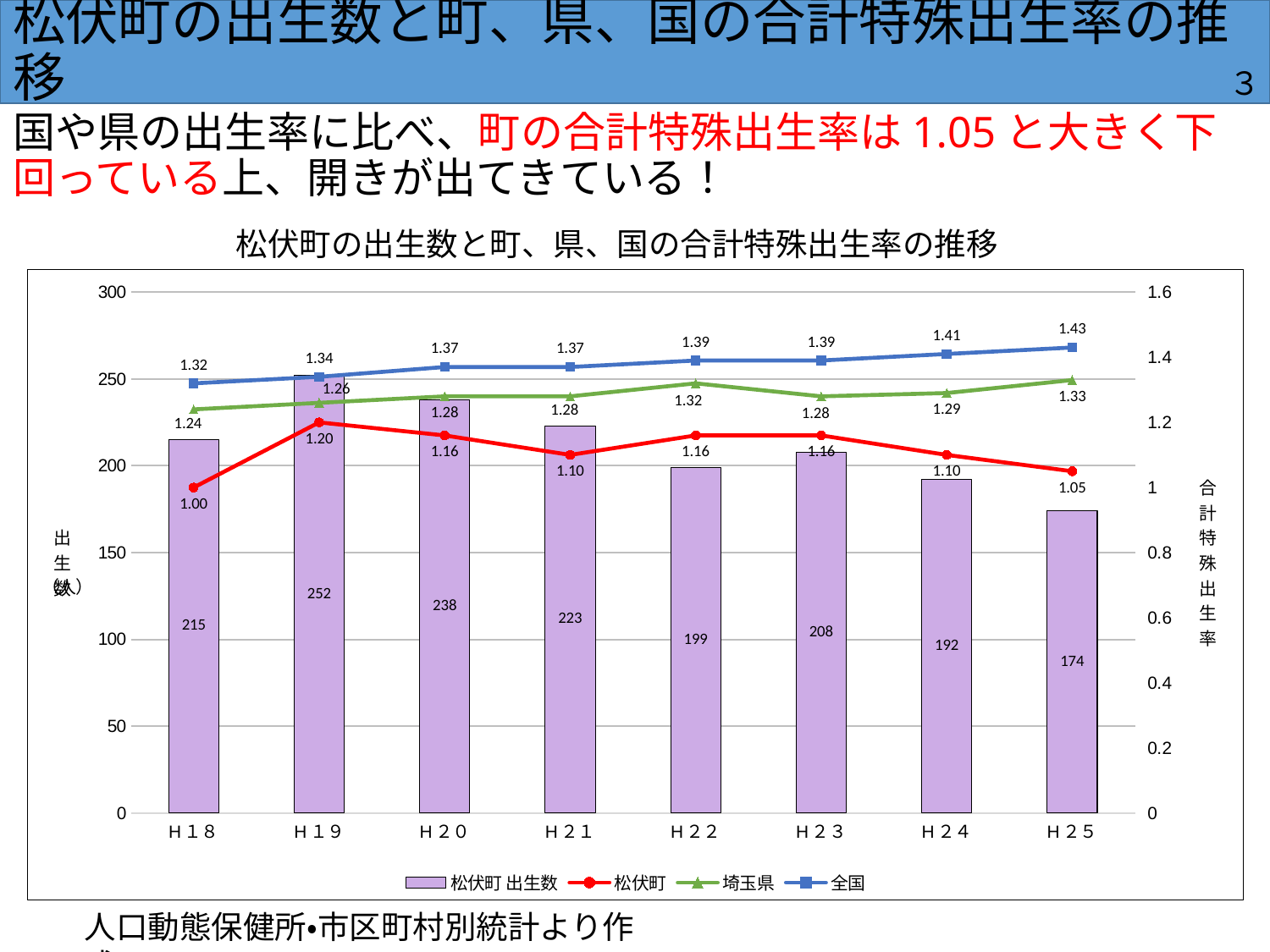
In which year is the number of births (松伏町 出生数) the highest? H19 Which is larger in H25, the 全国 value or the 埼玉県 value? 全国 What is the 全国 value in H18? 1.32 What is the number of births (松伏町 出生数) in H19? 252 In which year is the number of births (松伏町 出生数) the lowest? H25 How many series does the legend list? 4 What is the 埼玉県 value in H22? 1.32 How many years are shown on the x axis? 8 Does the 全国 series rise or fall from H18 to H25? rise What is the difference in births between H19 and H25? 78 What is the 松伏町 total fertility rate value in H25? 1.05 What is the difference between the 全国 and 松伏町 values in H25? 0.38